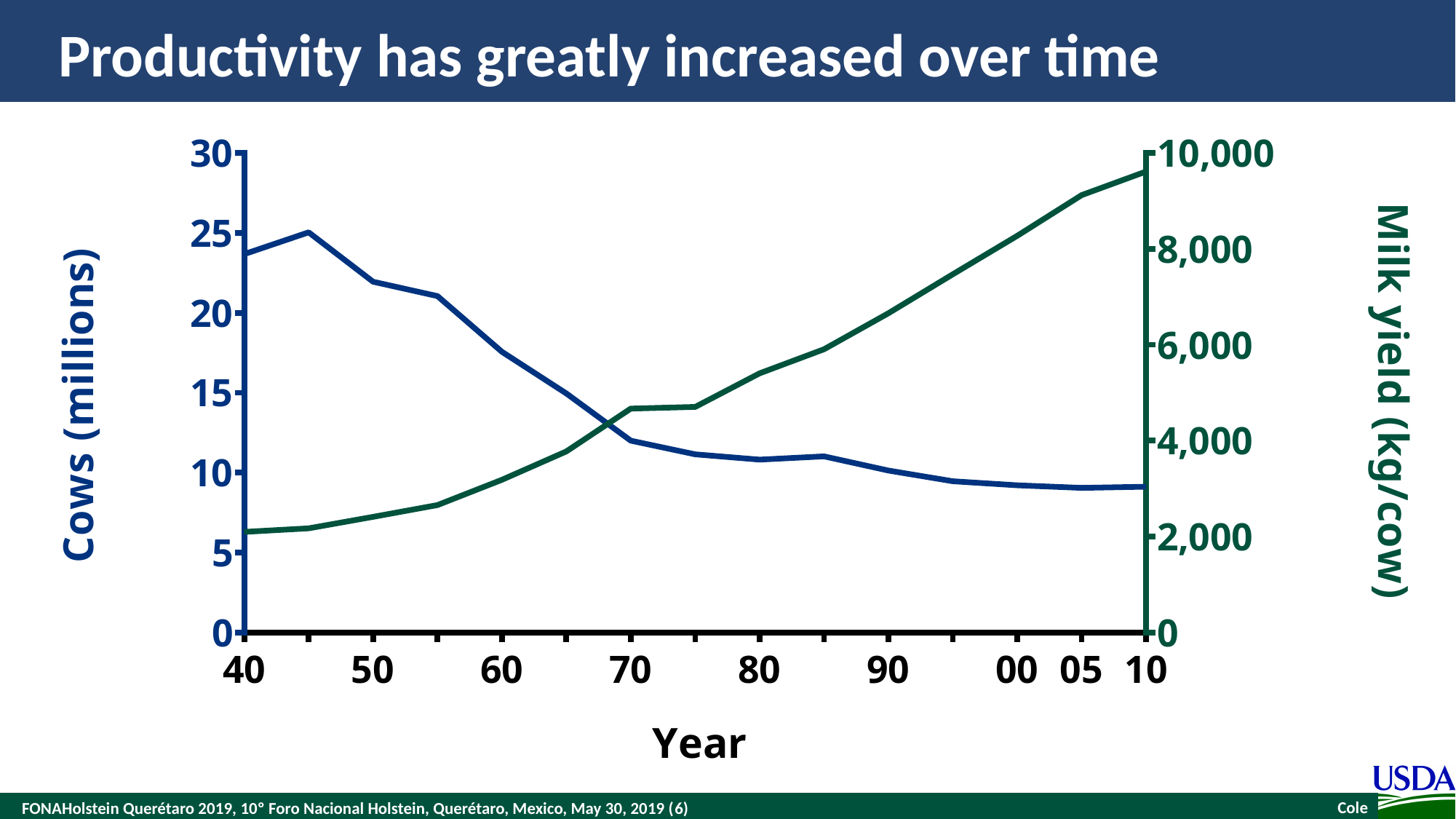
What kind of chart is shown on the slide? line chart Does the number of cows (millions) rise or fall from year 40 to year 10 along the x axis? fall What is the label of the right-hand vertical axis? Milk yield (kg/cow) Does the milk yield (kg/cow) rise or fall from year 40 to year 10 along the x axis? rise What is the title of the chart on the slide? Productivity has greatly increased over time Is the number of cows (millions) in year 10 greater or less than 10? less Is the milk yield (kg/cow) in year 80 greater or less than 4,000? greater Is the milk yield (kg/cow) in year 10 greater or less than 8,000? greater In which year is the milk yield (kg/cow) highest? 10